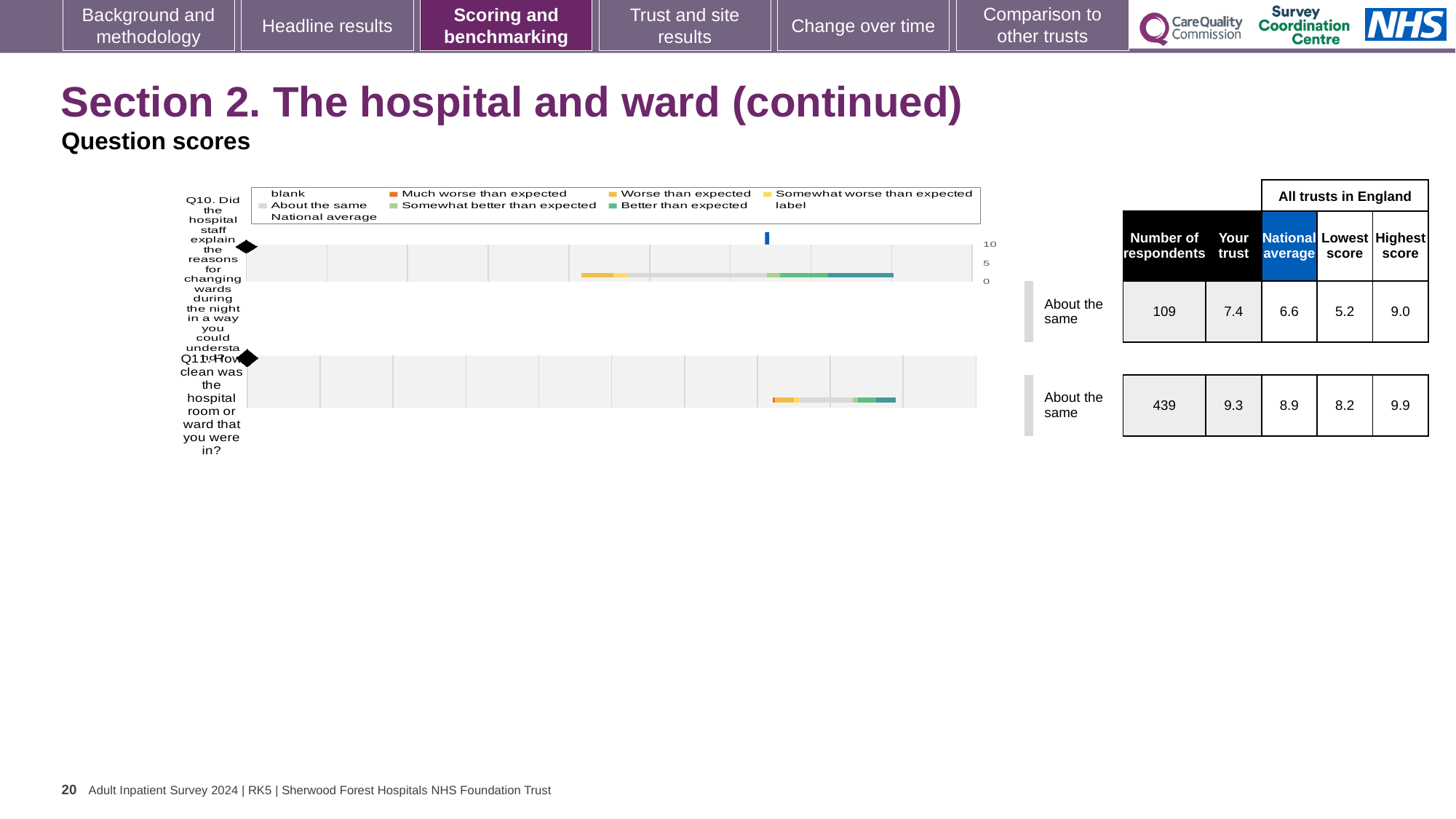
What benchmark category is shown for Q10 and Q11? About the same What is the 'Your trust' score for Q10 (explaining reasons for changing wards during the night)? 7.4 How many questions are plotted in the chart on this slide? 2 What is the difference between the trust's score and the national average for Q10? 0.8 What is the highest score among all trusts in England for Q11? 9.9 What kind of chart is used to show the question scores on this slide? bar chart What is the national average score for Q11 (how clean was the hospital room or ward)? 8.9 How many respondents answered Q11 (how clean was the hospital room or ward)? 439 Which question has the higher 'Your trust' score, Q10 or Q11? Q11 What is the lowest score among all trusts in England for Q10? 5.2 Which legend entry is shown in dark orange? Much worse than expected Is the trust's score for Q11 greater or less than 5 on the chart axis? greater